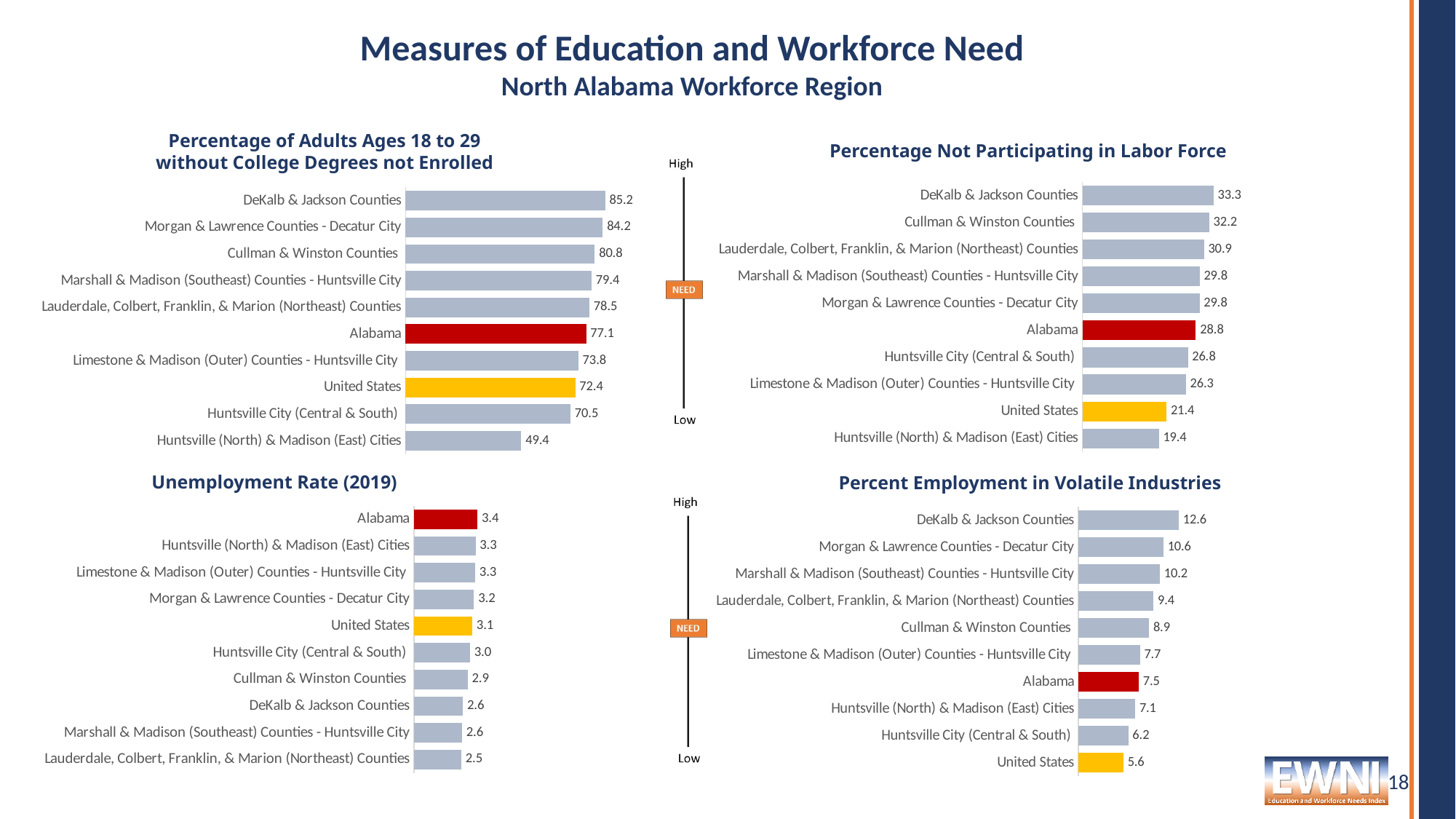
In the 'Unemployment Rate (2019)' chart, what is the value for Cullman & Winston Counties? 2.9 In the 'Unemployment Rate (2019)' chart, which category has the highest value? Alabama In the 'Unemployment Rate (2019)' chart, how many categories are shown? 10 In the 'Percentage Not Participating in Labor Force' chart, what is the value for the United States? 21.4 In the 'Percentage Not Participating in Labor Force' chart, what is the difference between DeKalb & Jackson Counties and Huntsville (North) & Madison (East) Cities? 13.9 What type of chart is the 'Unemployment Rate (2019)' chart? Bar chart In the 'Percent Employment in Volatile Industries' chart, what is the difference between Alabama and the United States? 1.9 In the 'Percent Employment in Volatile Industries' chart, what is the value for DeKalb & Jackson Counties? 12.6 In the 'Percentage of Adults Ages 18 to 29 without College Degrees not Enrolled' chart, what is the value for Alabama? 77.1 In the 'Percentage Not Participating in Labor Force' chart, which category has the highest value? DeKalb & Jackson Counties In the 'Percent Employment in Volatile Industries' chart, which is larger: Alabama or the United States? Alabama In the 'Percentage of Adults Ages 18 to 29 without College Degrees not Enrolled' chart, which category has the lowest value? Huntsville (North) & Madison (East) Cities